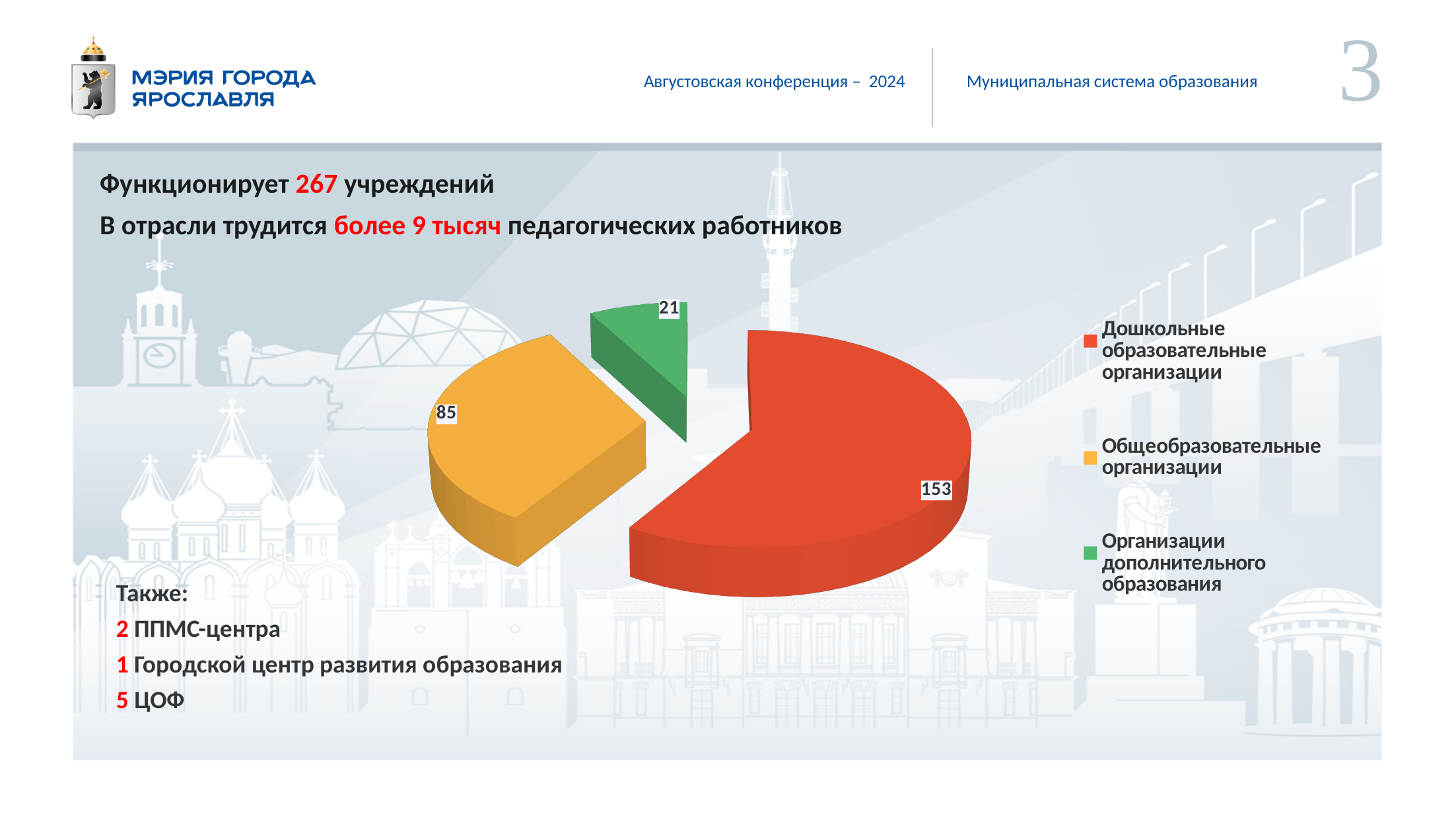
What is the value for Общеобразовательные организации in the pie chart? 85 What is the difference between the values for Дошкольные образовательные организации and Общеобразовательные организации? 68 What type of chart is shown on the slide? pie chart Which is larger: the value for Общеобразовательные организации or the value for Организации дополнительного образования? Общеобразовательные организации How many slices does the pie chart have? 3 What is the value for Дошкольные образовательные организации in the pie chart? 153 How many entries does the legend of the pie chart list? 3 What colour is the slice for Общеобразовательные организации in the pie chart? orange What is the total of all three slices in the pie chart? 259 Which category has the largest slice in the pie chart? Дошкольные образовательные организации What is the value for Организации дополнительного образования in the pie chart? 21 Which category has the smallest slice in the pie chart? Организации дополнительного образования